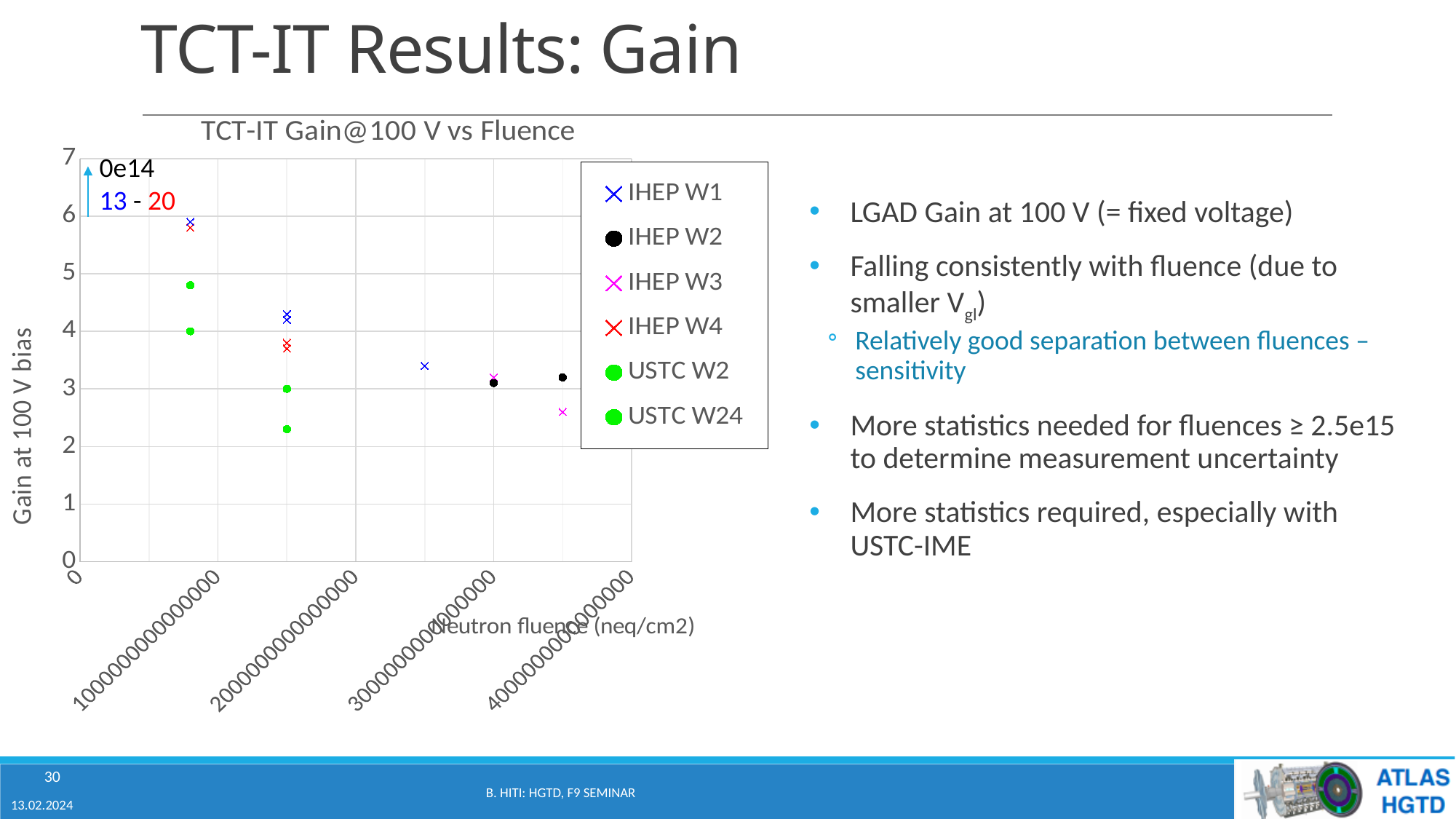
What is the title of the chart? TCT-IT Gain@100 V vs Fluence Is the lowest USTC (green) value greater or less than 3? less What kind of chart is shown on the slide? Scatter chart What is the label of the vertical axis of the chart? Gain at 100 V bias Do the gain values rise or fall as neutron fluence increases along the x axis? Fall How many series does the legend of the chart list? 6 At the fluence around 1.5e15, which series has the higher gain: IHEP W1 or IHEP W4? IHEP W1 Is the highest IHEP W1 value (at the lowest fluence) greater or less than 5? greater Are the IHEP W2 values greater or less than 4? less At the highest fluence (around 3.5e15), which series has the higher gain: IHEP W2 or IHEP W3? IHEP W2